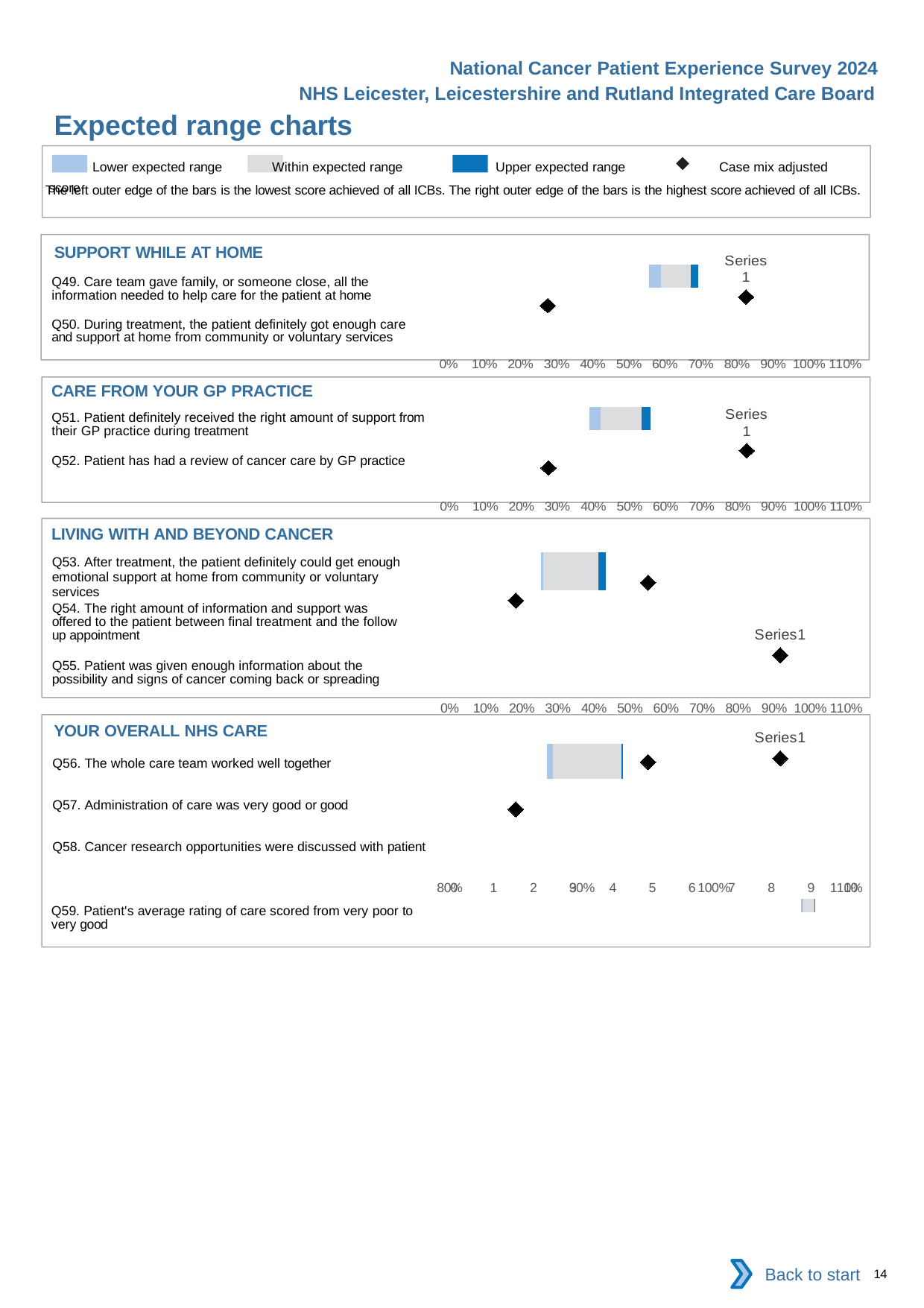
How many questions are listed in the 'Care from your GP practice' section? 2 What is the title of the slide? Expected range charts In the 'Your overall NHS care' chart, which is larger: the diamond marker below the 'Series1' label or the leftmost diamond marker? The diamond below the 'Series1' label In the 'Living with and beyond cancer' chart, is the diamond marker below the 'Series1' label greater or less than 80%? greater How many questions are listed in the 'Living with and beyond cancer' section? 3 In the 'Living with and beyond cancer' chart, is the leftmost diamond marker greater or less than 30%? less How many questions are listed in the 'Your overall NHS care' section? 4 In the 'Support while at home' chart, is the diamond marker below the 'Series 1' label greater or less than 70%? greater According to the legend, what does the black diamond marker represent? Case mix adjusted score What kind of chart is used in the 'Support while at home' section? Bar chart